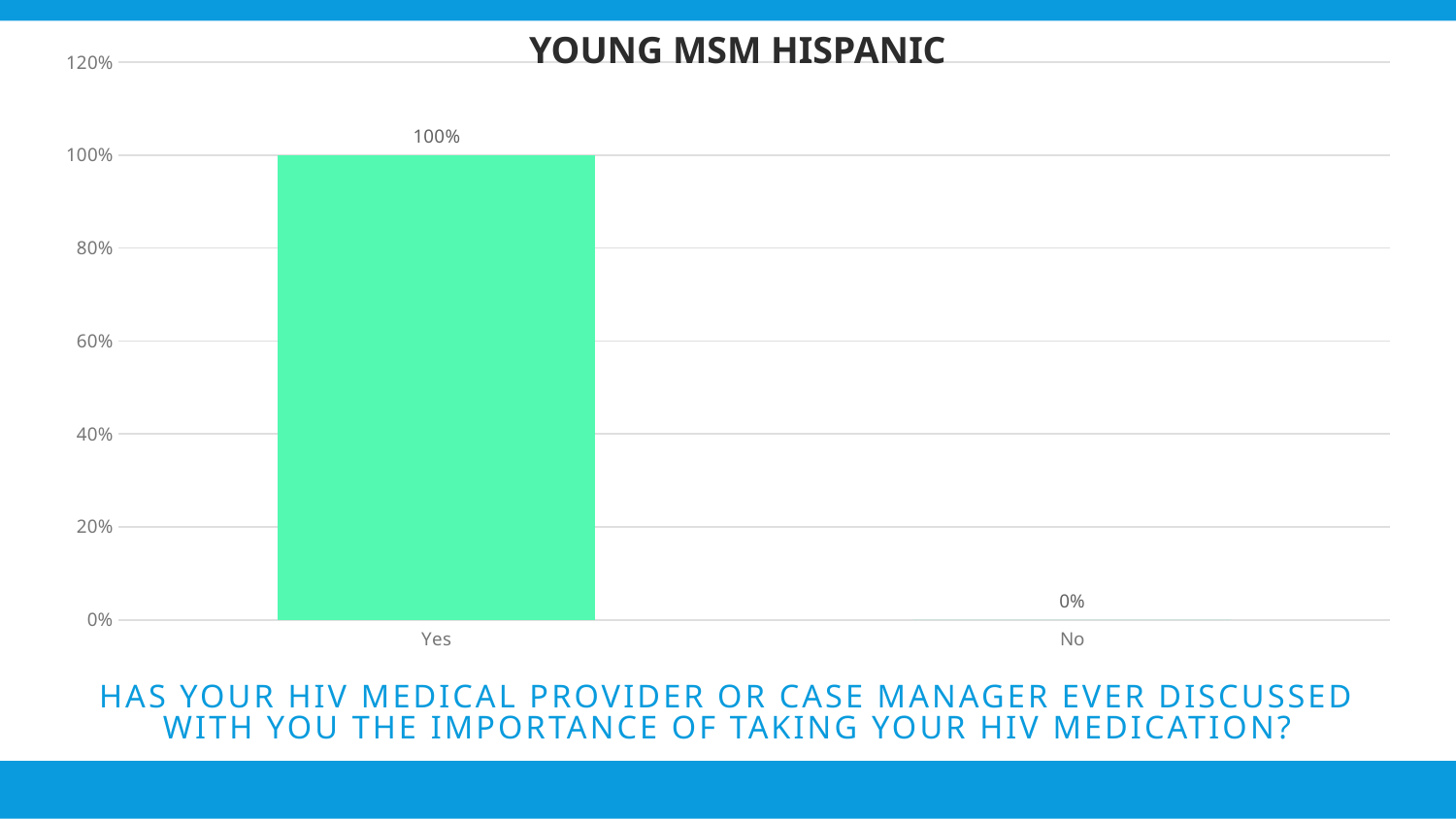
Which category has the highest value? Yes How many categories are shown on the x axis? 2 What is the difference between the values for Yes and No? 100% What is the value for Yes? 100% Which category has the lowest value? No What kind of chart is shown on the slide? bar chart Is the value for Yes greater or less than 80%? greater What is the value for No? 0% Which is larger, the value for Yes or the value for No? Yes What is the title of the chart? YOUNG MSM HISPANIC What is the highest value shown on the y axis? 120%